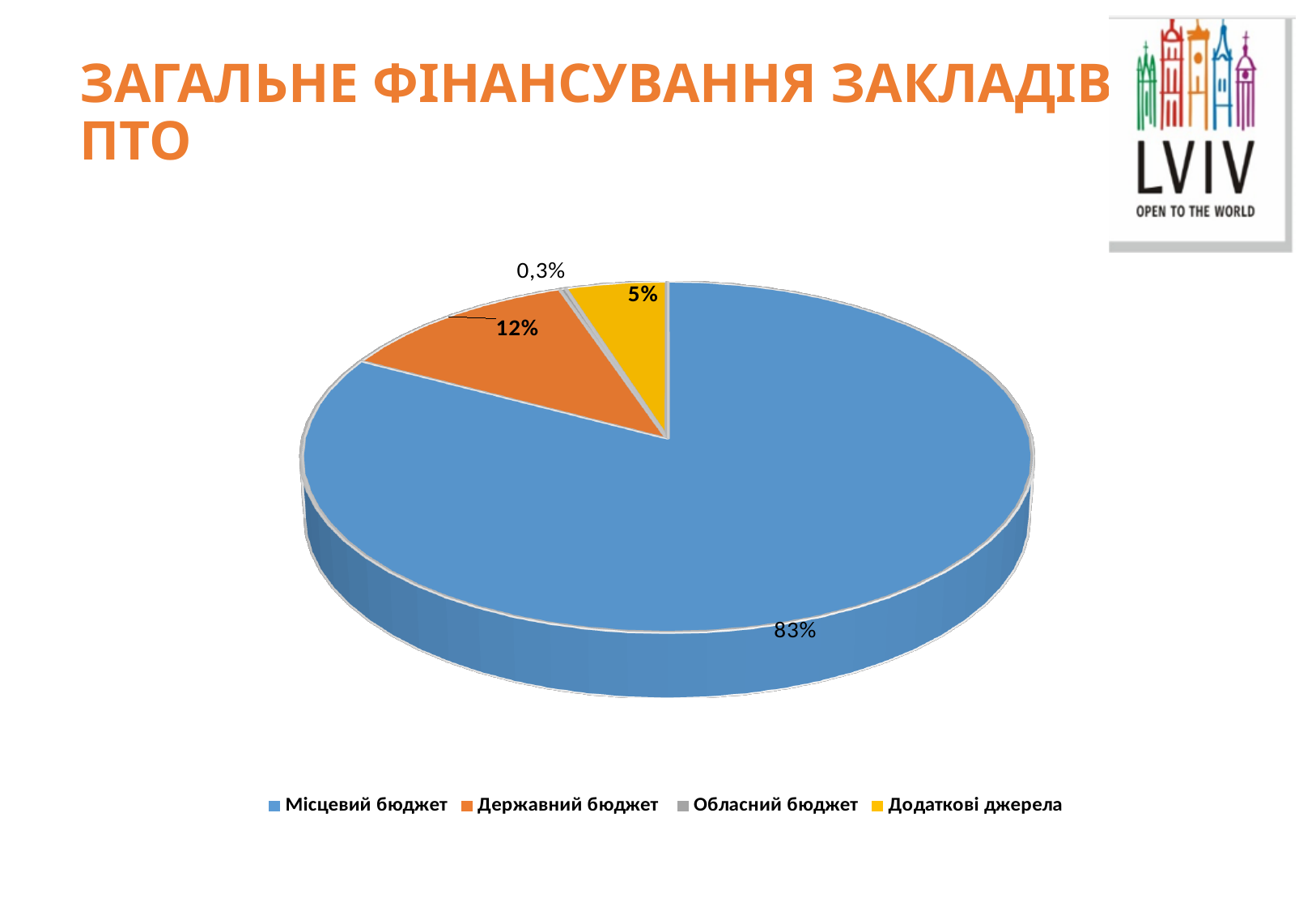
Which category has the largest slice of the pie? Місцевий бюджет How many categories does the pie chart show? 4 What share of the pie does Державний бюджет have? 12% What type of chart is shown on the slide? pie chart What is the difference in percentage points between Місцевий бюджет and Державний бюджет? 71 Which category has the smallest slice of the pie? Обласний бюджет What share of the pie does Додаткові джерела have? 5% What is the title of the slide containing the chart? ЗАГАЛЬНЕ ФІНАНСУВАННЯ ЗАКЛАДІВ ПТО Which is larger, the slice for Державний бюджет or the slice for Додаткові джерела? Державний бюджет What share of the pie does Обласний бюджет have? 0,3% What share of the pie does Місцевий бюджет have? 83% What colour is the slice for Додаткові джерела? yellow